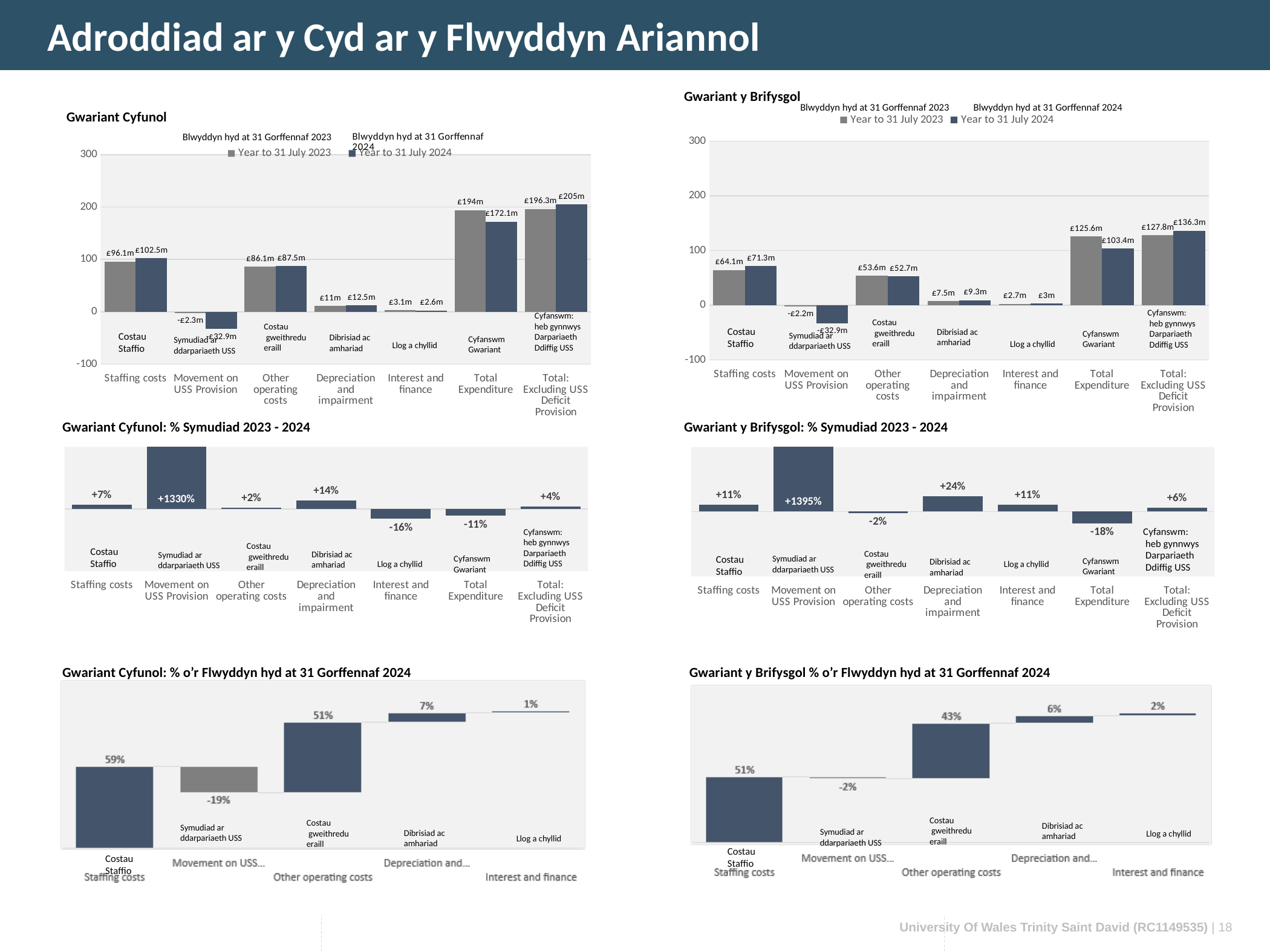
In the 'Gwariant Cyfunol: % Symudiad 2023 - 2024' chart, which category has the lowest value? Interest and finance In the 'Gwariant Cyfunol' chart, what is the value for Total Expenditure in the Year to 31 July 2023 series? £194m In the 'Gwariant Cyfunol' chart, what is the difference between the Year to 31 July 2024 and Year to 31 July 2023 values for Staffing costs? £6.4m In the 'Gwariant y Brifysgol % o'r Flwyddyn hyd at 31 Gorffennaf 2024' chart, what is the value for Other operating costs? 43% In the 'Gwariant Cyfunol' chart, what is the value for Staffing costs in the Year to 31 July 2024 series? £102.5m In the 'Gwariant y Brifysgol' chart, is the Year to 31 July 2024 value for Total: Excluding USS Deficit Provision greater or less than 100? greater In the 'Gwariant y Brifysgol: % Symudiad 2023 - 2024' chart, what is the value for Depreciation and impairment? +24% How many series does the legend of the 'Gwariant y Brifysgol' chart list? 2 In the 'Gwariant y Brifysgol' chart, what is the value for Other operating costs in the Year to 31 July 2023 series? £53.6m In the 'Gwariant Cyfunol: % Symudiad 2023 - 2024' chart, what is the value for Movement on USS Provision? +1330% In the 'Gwariant y Brifysgol' chart, which is larger for Total Expenditure: the Year to 31 July 2023 value or the Year to 31 July 2024 value? Year to 31 July 2023 How many categories are shown in the 'Gwariant Cyfunol: % o'r Flwyddyn hyd at 31 Gorffennaf 2024' chart? 5